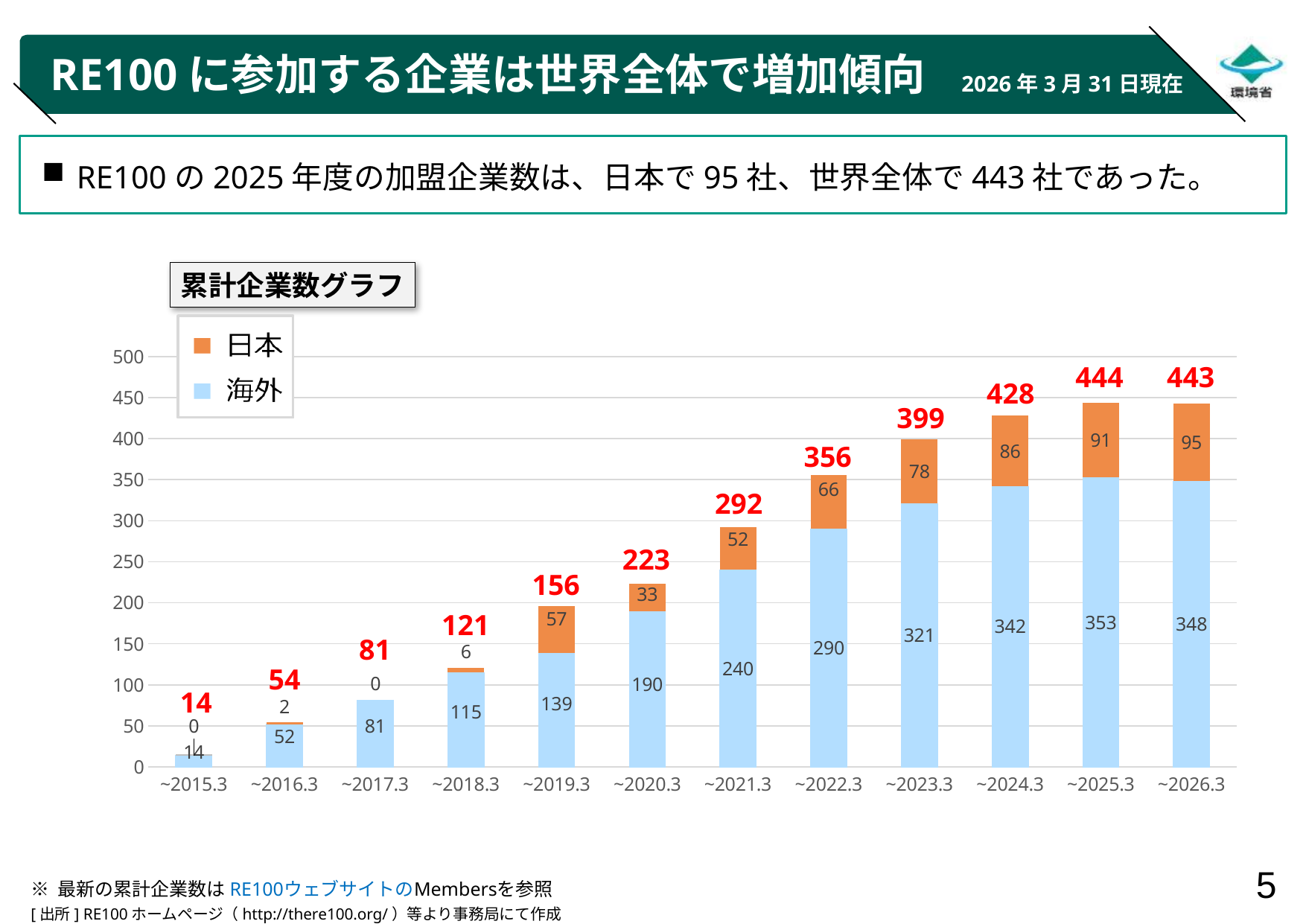
How many series does the legend list? 2 Which series is shown in orange? 日本 Which category has the lowest total? ~2015.3 What is the difference between the 海外 values for ~2025.3 and ~2026.3? 5 What is the total of the stacked bar for ~2024.3? 428 What kind of chart is shown? stacked bar chart Is the total for ~2022.3 greater or less than 300? greater What is the value for 日本 in ~2026.3? 95 Which is larger, the 日本 value for ~2023.3 or for ~2021.3? ~2023.3 What is the value for 海外 in ~2022.3? 290 How many categories are shown on the x axis? 12 Which category has the highest total? ~2025.3